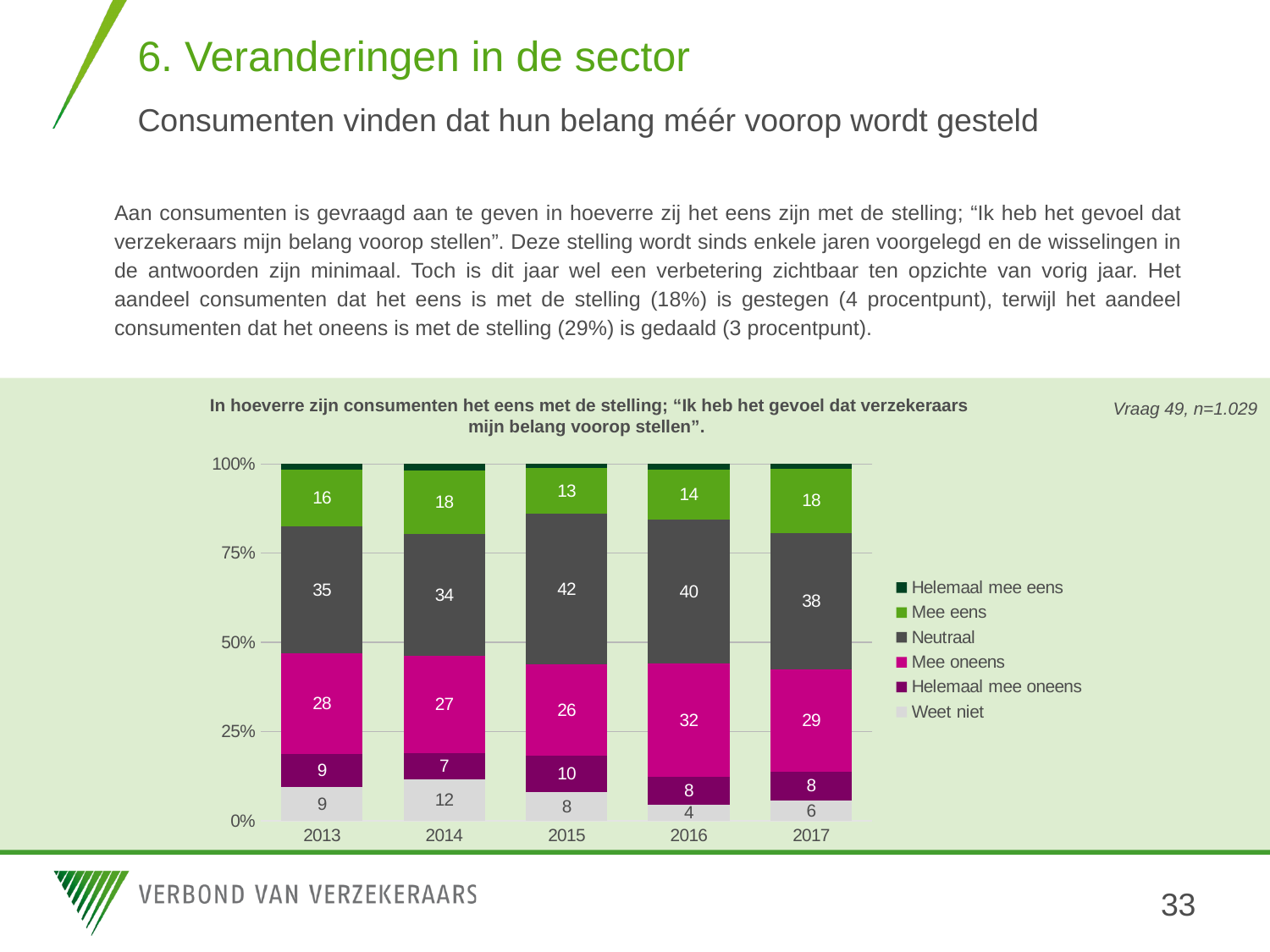
Which series is shown in the legend directly below Neutraal? Mee oneens What type of chart is shown on the slide? stacked bar chart What is the difference between the Mee oneens values for 2016 and 2017? 3 What is the value for Mee oneens in 2016? 32 How many years are shown on the x axis? 5 Which is larger, the Mee eens value in 2015 or in 2017? 2017 How many series does the legend list? 6 What is the value for Neutraal in 2015? 42 In which year is the Weet niet value lowest? 2016 In which year is the Neutraal value highest? 2015 What is the value for Weet niet in 2014? 12 What is the value for Mee eens in 2017? 18